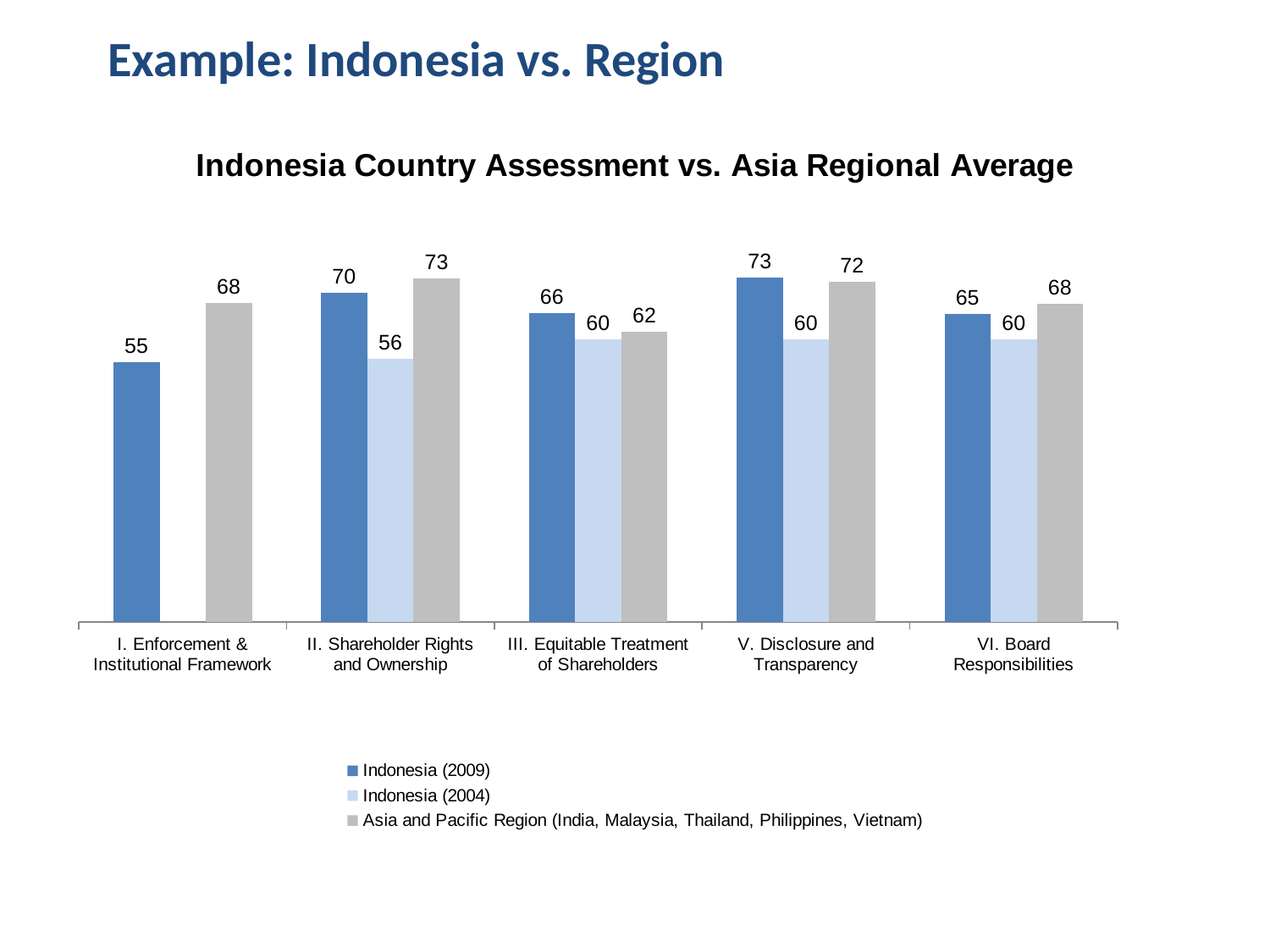
What kind of chart is shown on the slide? Bar chart What is the difference between the Asia and Pacific Region value and the Indonesia (2009) value for I. Enforcement & Institutional Framework? 13 Which category has the highest Indonesia (2009) value? V. Disclosure and Transparency What is the difference between the Indonesia (2009) and Indonesia (2004) values for II. Shareholder Rights and Ownership? 14 Which category has the lowest Indonesia (2009) value? I. Enforcement & Institutional Framework What is the Indonesia (2009) value for I. Enforcement & Institutional Framework? 55 What is the Indonesia (2004) value for III. Equitable Treatment of Shareholders? 60 How many categories are shown on the x axis? 5 What is the title of the chart? Indonesia Country Assessment vs. Asia Regional Average What is the Asia and Pacific Region value for II. Shareholder Rights and Ownership? 73 Which is larger for V. Disclosure and Transparency: the Indonesia (2009) value or the Asia and Pacific Region value? Indonesia (2009) How many series does the legend list? 3